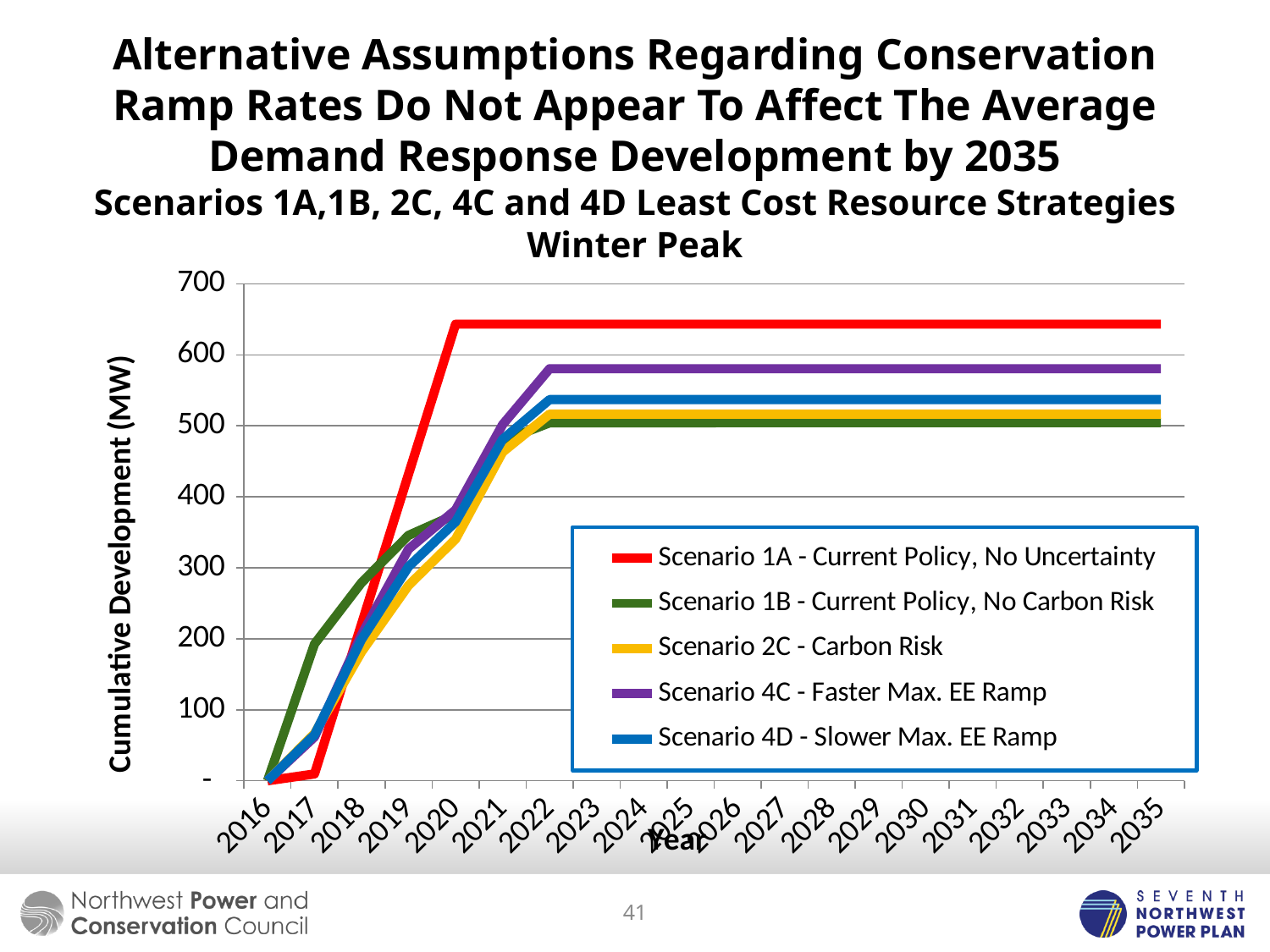
What is the label on the y axis? Cumulative Development (MW) Is the value for Scenario 4D in 2030 greater or less than 500? greater Which scenario has the highest cumulative development in 2035? Scenario 1A - Current Policy, No Uncertainty Is the value for Scenario 1A in 2035 greater or less than 600? greater Which scenario has the lowest cumulative development in 2017? Scenario 1A - Current Policy, No Uncertainty How many series does the legend list? 5 Which is larger in 2035, the value for Scenario 1A or the value for Scenario 4C? Scenario 1A What kind of chart is shown on the slide? Line chart Do the values for Scenario 1A rise or fall from 2016 to 2020? rise How many years are shown along the x axis? 20 Which scenario has the highest cumulative development in 2017? Scenario 1B - Current Policy, No Carbon Risk Is the value for Scenario 1B in 2035 greater or less than 600? less